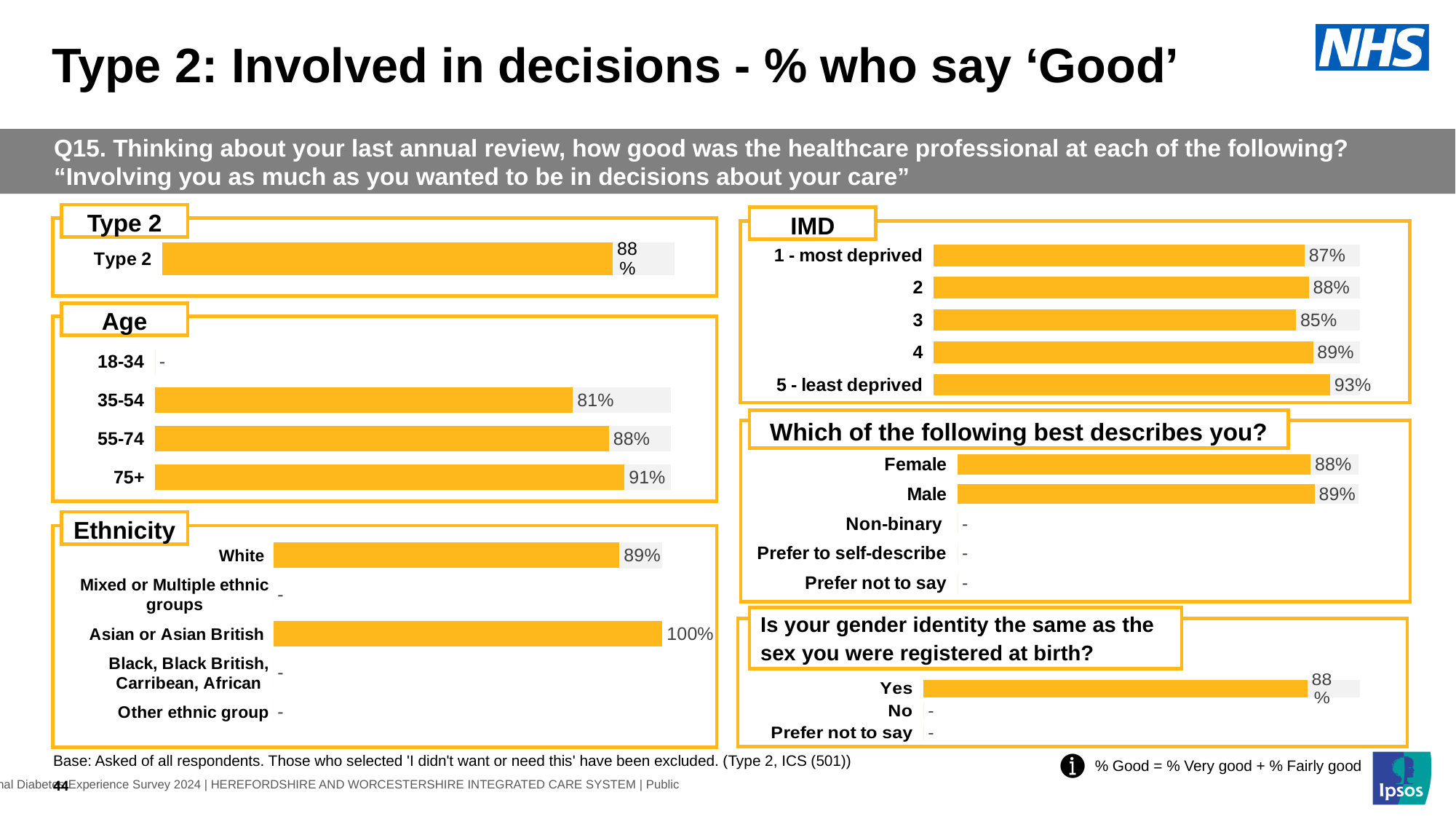
In the Type 2 chart, what percentage of Type 2 respondents say 'Good'? 88% In the IMD chart, which IMD group has the lowest percentage? 3 In the IMD chart, how many IMD categories are shown? 5 What type of chart is used in the IMD section? Bar chart In the Age chart, what is the difference between the 75+ and 35-54 values? 10 percentage points In the Age chart, which age group with a plotted value has the highest percentage? 75+ In the Age chart, what is the value for the 35-54 age group? 81% In the IMD chart, what is the value for 5 - least deprived? 93% In the Ethnicity chart, what is the value for Asian or Asian British? 100% In the IMD chart, what is the difference between 5 - least deprived and 1 - most deprived? 6 percentage points In the Ethnicity chart, which is larger, the value for White or for Asian or Asian British? Asian or Asian British In the 'Which of the following best describes you?' chart, what is the value for Male? 89%